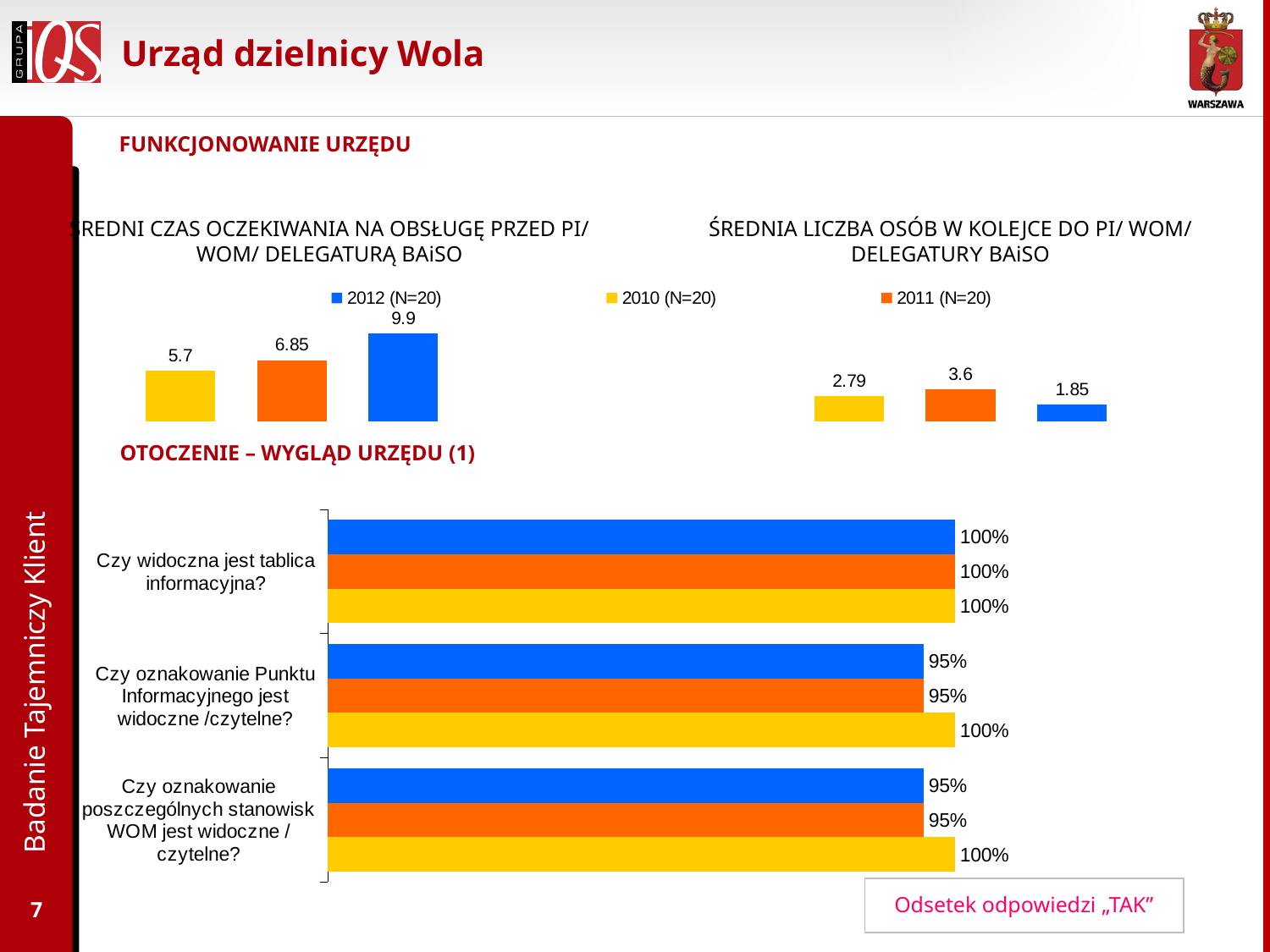
In the top-left chart (ŚREDNI CZAS OCZEKIWANIA NA OBSŁUGĘ), what is the value for 2012 (N=20)? 9.9 In the top-right chart (ŚREDNIA LICZBA OSÓB W KOLEJCE), what is the value for 2011 (N=20)? 3.6 In the bottom chart (OTOCZENIE – WYGLĄD URZĘDU), what is the 2012 value for 'Czy oznakowanie Punktu Informacyjnego jest widoczne /czytelne?'? 95% In the top-right chart (ŚREDNIA LICZBA OSÓB W KOLEJCE), which year has the lowest value? 2012 (N=20) What type of chart is the bottom chart (OTOCZENIE – WYGLĄD URZĘDU)? Bar chart In the top-right chart (ŚREDNIA LICZBA OSÓB W KOLEJCE), what is the difference between the 2011 and 2012 values? 1.75 In the bottom chart (OTOCZENIE – WYGLĄD URZĘDU), what is the 2010 value for 'Czy oznakowanie poszczególnych stanowisk WOM jest widoczne / czytelne?'? 100% In the top-left chart (ŚREDNI CZAS OCZEKIWANIA NA OBSŁUGĘ), what is the difference between the 2012 and 2010 values? 4.2 How many question categories are shown in the bottom chart (OTOCZENIE – WYGLĄD URZĘDU)? 3 In the top-left chart (ŚREDNI CZAS OCZEKIWANIA NA OBSŁUGĘ), which year has the highest value? 2012 (N=20) In the top-left chart (ŚREDNI CZAS OCZEKIWANIA NA OBSŁUGĘ), what is the value for 2010 (N=20)? 5.7 In the top-right chart (ŚREDNIA LICZBA OSÓB W KOLEJCE), which is larger: the value for 2010 or the value for 2011? 2011